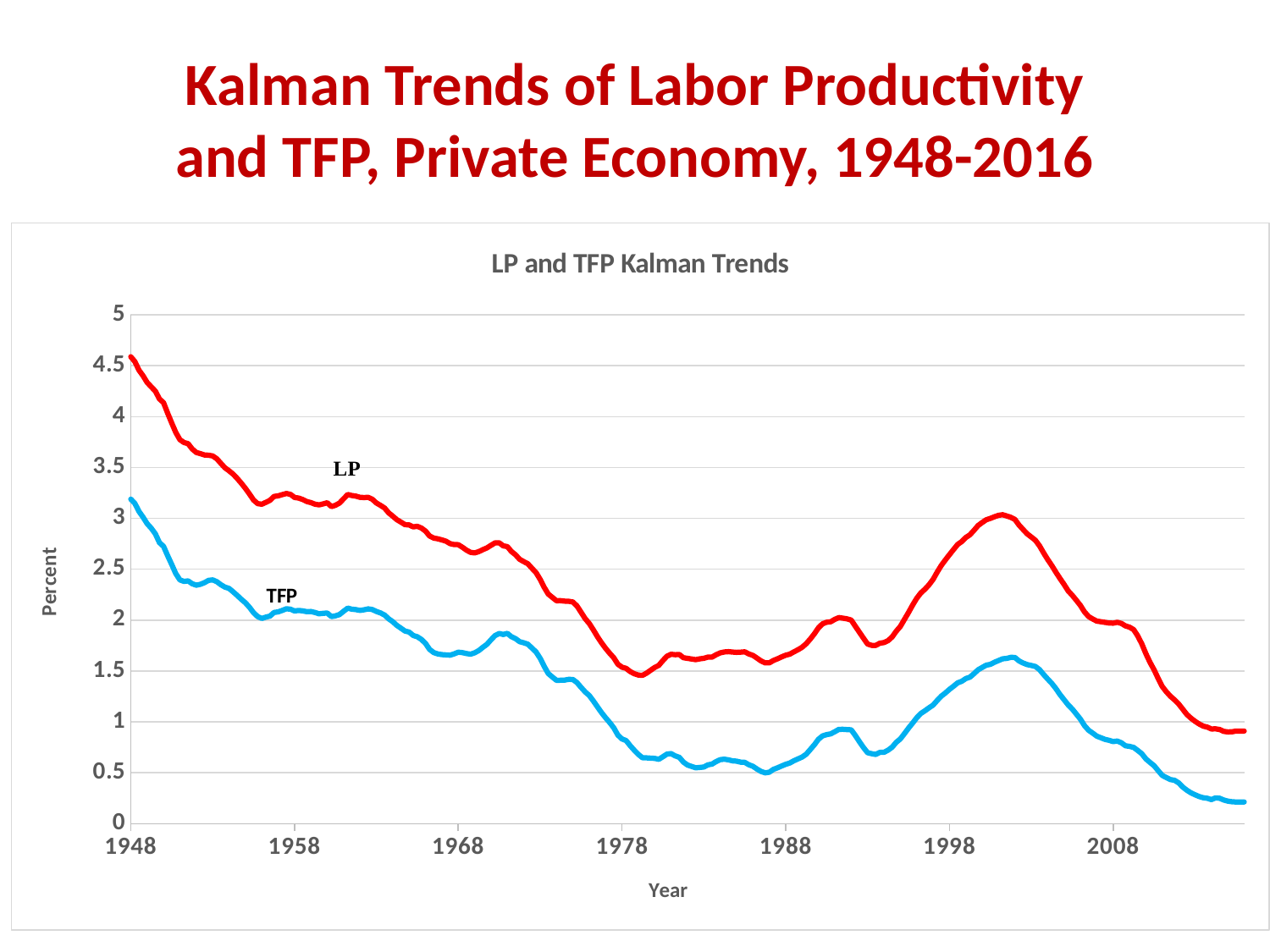
Is the LP value in 1978 greater or less than 2? less Is the TFP value in 1948 greater or less than 3? greater What kind of chart is shown on the slide? line chart Overall, does the LP trend rise or fall from 1948 to the end of the series? fall How many series are plotted in the chart? 2 What is the label on the vertical axis? Percent Is the LP value in 1998 greater or less than 2? greater Which series has the higher value in 1948, LP or TFP? LP What is the title of the chart? LP and TFP Kalman Trends